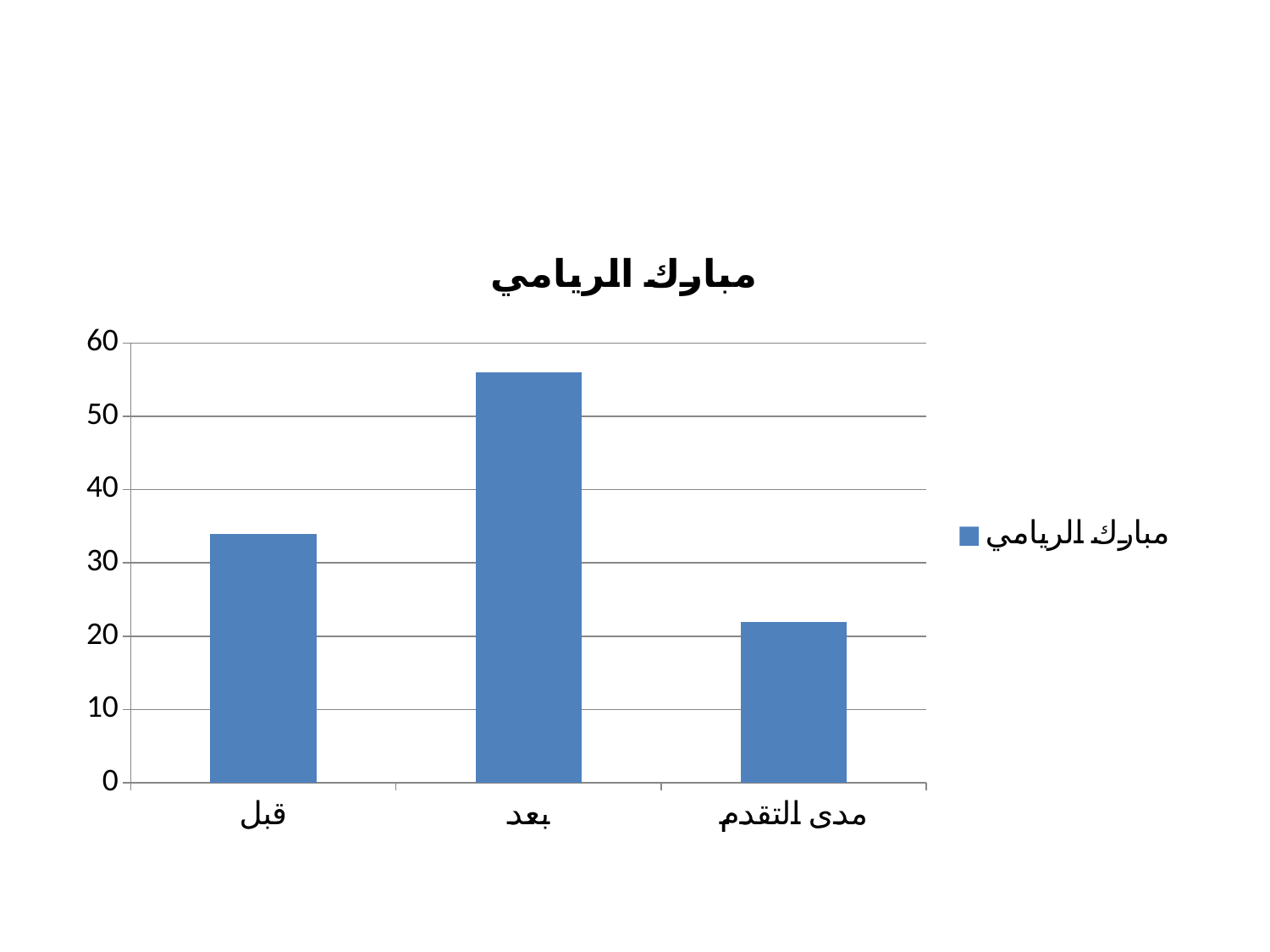
Which is larger, the value for قبل or the value for بعد? بعد Is the value for قبل greater or less than 30? greater Is the value for مدى التقدم greater or less than 30? less Which category has the lowest bar? مدى التقدم How many categories are shown on the x axis? 3 What is the highest value shown on the vertical axis? 60 How many series does the legend list? 1 Which category has the highest bar? بعد Is the value for قبل greater or less than 40? less What is the title of the chart? مبارك الريامي What kind of chart is shown on the slide? bar chart